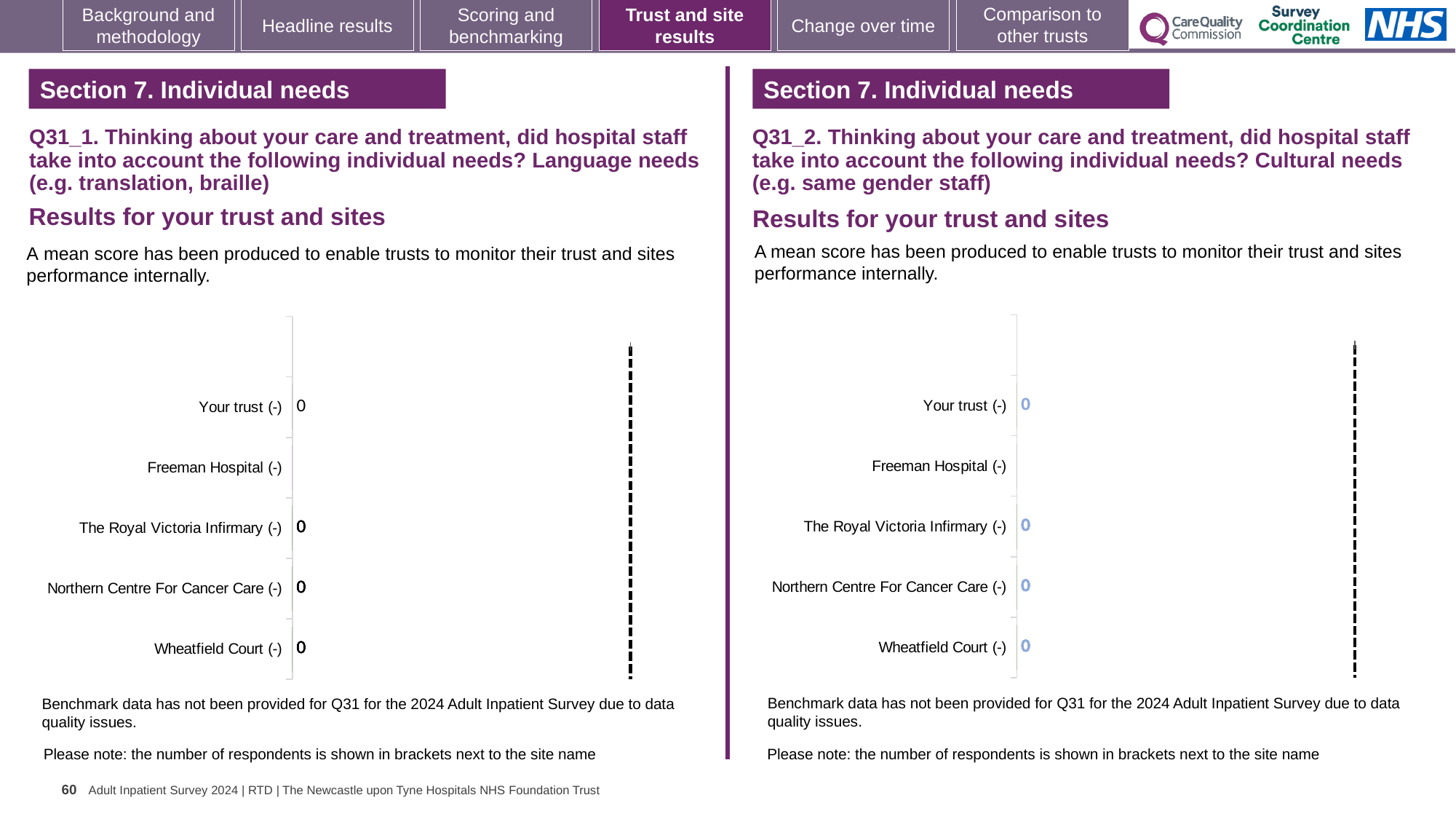
What kind of chart is the left chart (Q31_1, Language needs)? Bar chart In the right chart (Q31_2, Cultural needs), which category has no data label shown next to it? Freeman Hospital (-) In the right chart (Q31_2, Cultural needs), what is the value shown for Wheatfield Court? 0 In the right chart (Q31_2, Cultural needs), what is the value shown for Northern Centre For Cancer Care? 0 In the left chart (Q31_1, Language needs), what is the difference between the values for Your trust and Wheatfield Court? 0 What is shown in brackets next to each site name in the left chart (Q31_1, Language needs)? - In the left chart (Q31_1, Language needs), what is the value shown for Your trust? 0 In the left chart (Q31_1, Language needs), what is the value shown for Wheatfield Court? 0 How many categories are listed on the vertical axis of the right chart (Q31_2, Cultural needs)? 5 In the right chart (Q31_2, Cultural needs), what is the value shown for Your trust? 0 How many categories are listed on the vertical axis of the left chart (Q31_1, Language needs)? 5 In the left chart (Q31_1, Language needs), what is the value shown for The Royal Victoria Infirmary? 0